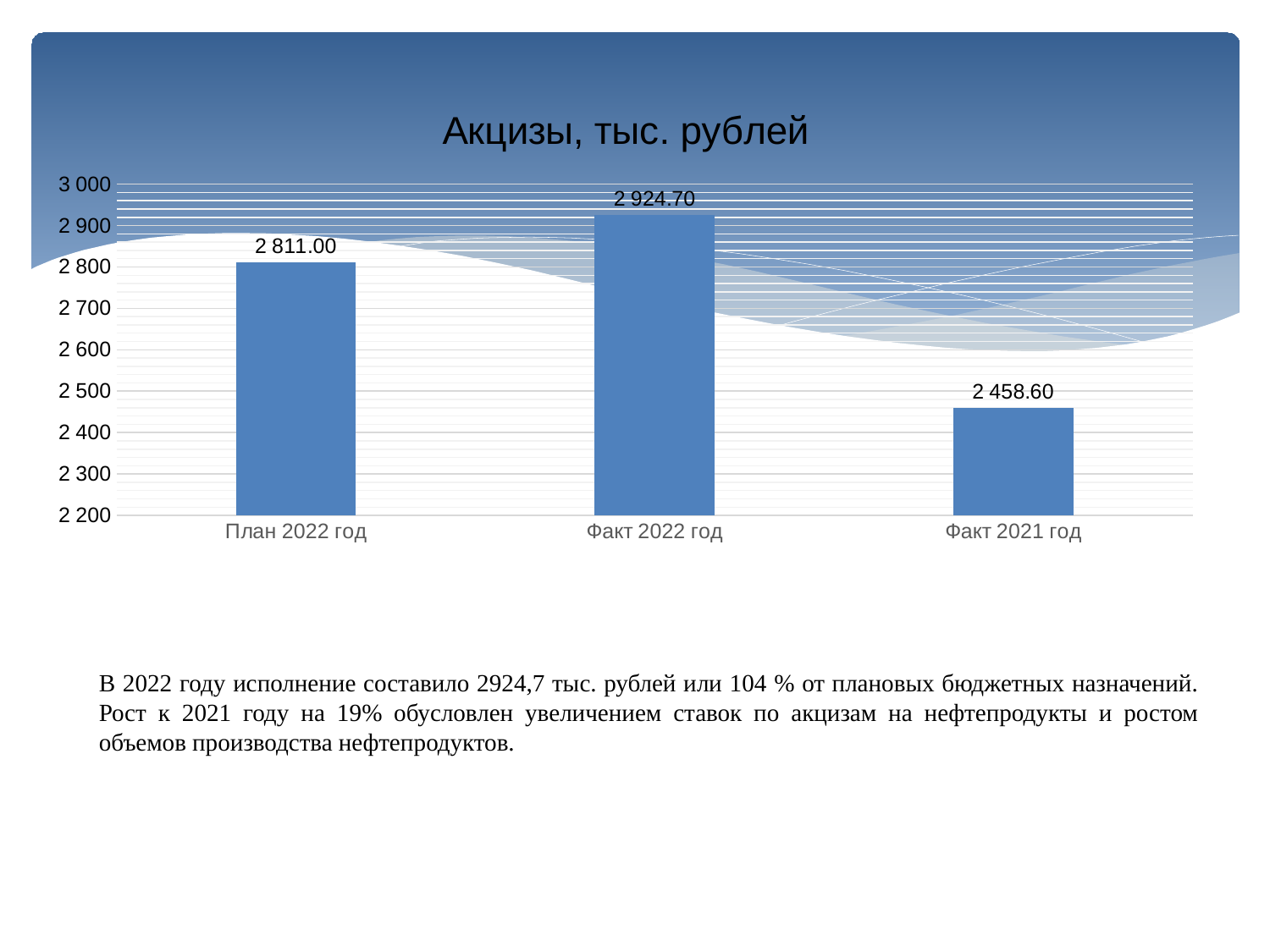
Which is larger, План 2022 год or Факт 2021 год? План 2022 год What is the title of the chart? Акцизы, тыс. рублей How many categories are shown in the chart? 3 What is the difference between Факт 2022 год and План 2022 год? 113.70 What is the value for План 2022 год? 2 811.00 What is the difference between Факт 2022 год and Факт 2021 год? 466.10 What kind of chart is shown on the slide? bar chart What is the value for Факт 2022 год? 2 924.70 Which category has the lowest value? Факт 2021 год Is the value for Факт 2021 год greater or less than 2 500? less What is the value for Факт 2021 год? 2 458.60 Which category has the highest value? Факт 2022 год